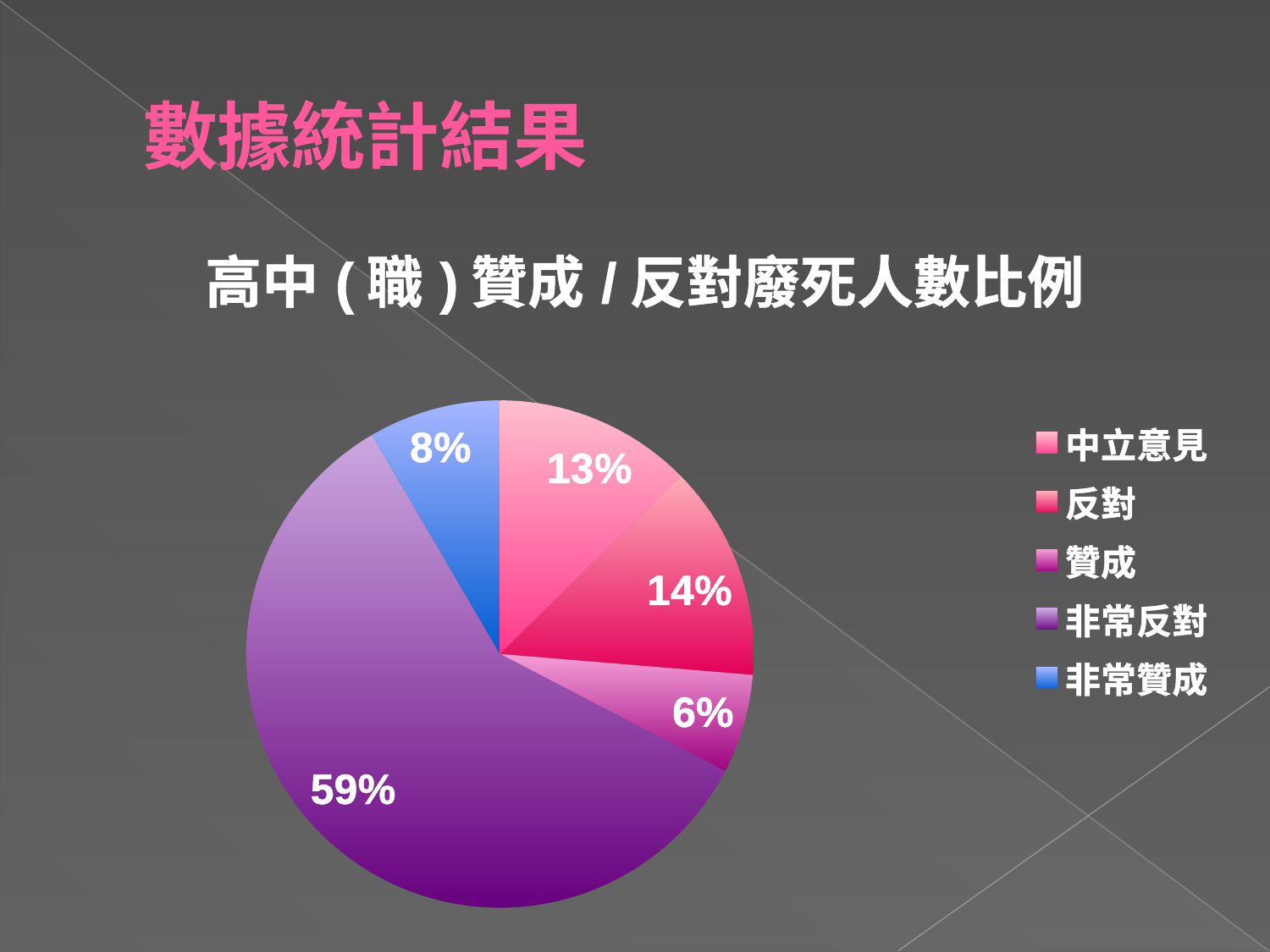
What is the value for 非常贊成? 8% Which category has the largest share of the pie? 非常反對 What is the value for 贊成? 6% What is the difference between the values for 非常反對 and 反對? 45% What is the value for 非常反對? 59% Which category has the smallest share of the pie? 贊成 Which is larger, the value for 反對 or the value for 中立意見? 反對 What is the title of the pie chart? 高中(職)贊成/反對廢死人數比例 What is the value for 反對? 14% How many categories does the pie chart have? 5 What is the value for 中立意見? 13% What kind of chart is shown on the slide? pie chart